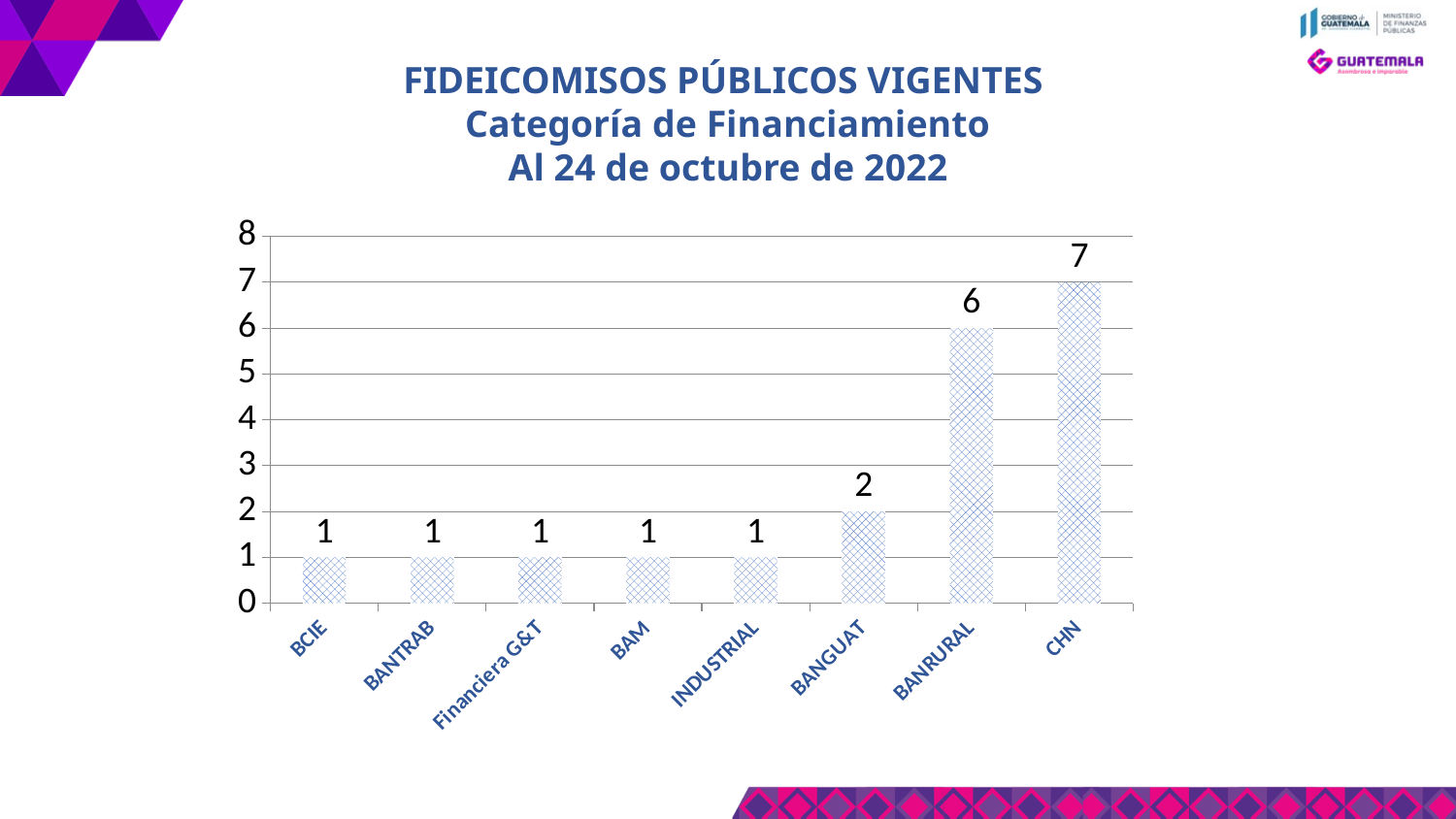
What kind of chart is shown on the slide? Bar chart What is the difference between the values for BANRURAL and BANGUAT? 4 What is the value for BANRURAL? 6 What is the value for Financiera G&T? 1 How many categories are shown on the x axis? 8 What is the value for CHN? 7 What is the date given in the chart title? 24 de octubre de 2022 How many categories have a value of 1? 5 Which category has the highest value? CHN What is the difference between the values for CHN and BANRURAL? 1 What is the value for BANGUAT? 2 Which is larger, the value for BANGUAT or the value for BAM? BANGUAT